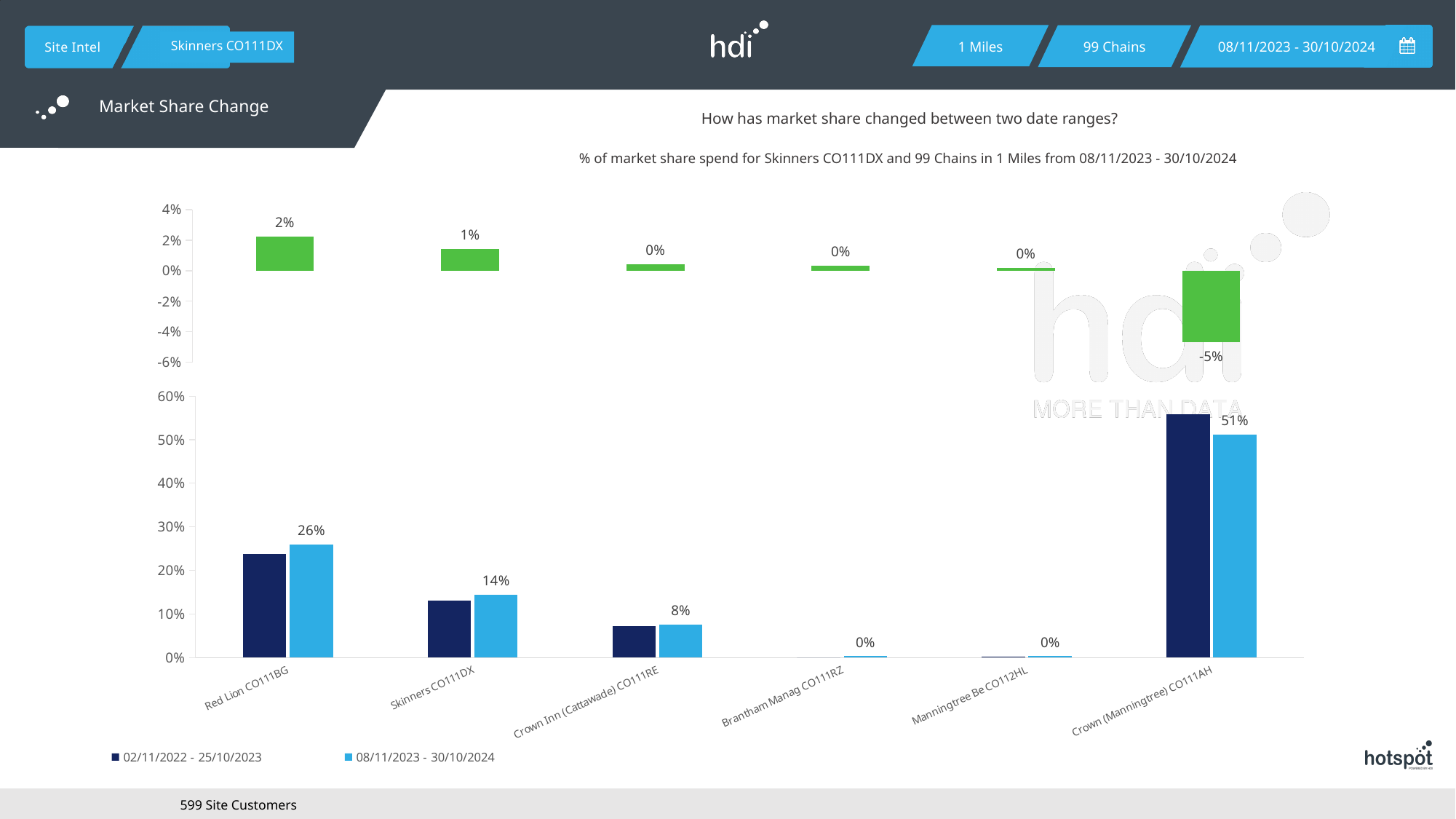
In the bottom chart, is the 02/11/2022 - 25/10/2023 value for Crown (Manningtree) CO111AH greater or less than 50%? greater In the top chart, what is the market share change for Crown (Manningtree) CO111AH? -5% In the bottom chart, what is the value for Skinners CO111DX in the 08/11/2023 - 30/10/2024 period? 14% In the bottom chart, what is the difference between the 08/11/2023 - 30/10/2024 values for Red Lion CO111BG and Crown Inn (Cattawade) CO111RE? 18% How many locations are shown on the x axis of the bottom chart? 6 In the bottom chart, is the 02/11/2022 - 25/10/2023 value for Red Lion CO111BG greater or less than 30%? less In the top chart, which location has the highest market share change? Red Lion CO111BG In the bottom chart, which is larger for Crown (Manningtree) CO111AH: the 02/11/2022 - 25/10/2023 bar or the 08/11/2023 - 30/10/2024 bar? 02/11/2022 - 25/10/2023 In the bottom chart, what is the value for Crown (Manningtree) CO111AH in the 08/11/2023 - 30/10/2024 period? 51% In the top chart, which location has the lowest market share change? Crown (Manningtree) CO111AH How many series does the legend of the bottom chart list? 2 In the top chart, what is the market share change for Red Lion CO111BG? 2%